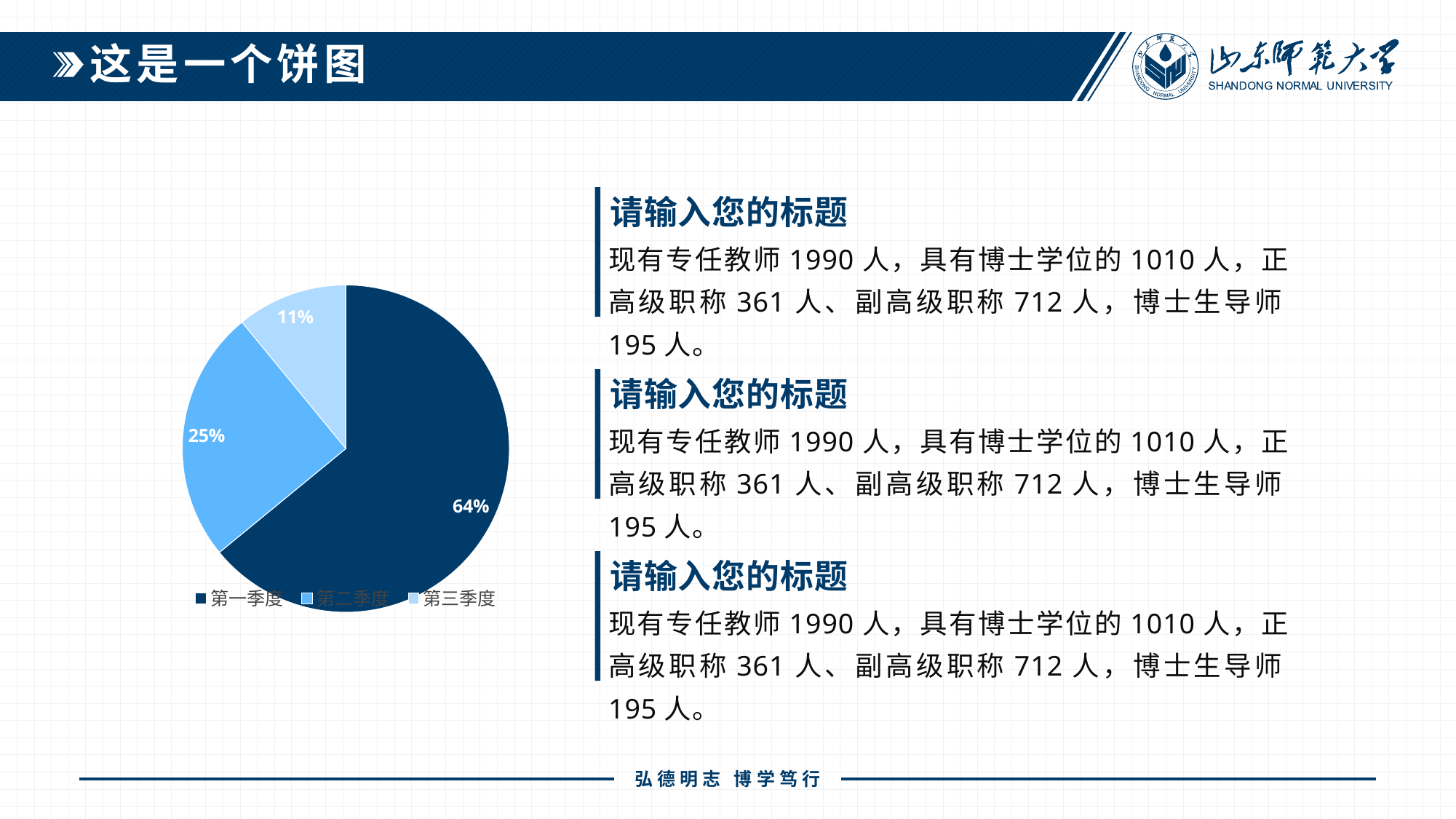
What share of the pie does 第一季度 represent? 64% What share of the pie does 第二季度 represent? 25% Which slice is larger, 第二季度 or 第三季度? 第二季度 What is the difference in percentage points between the 第二季度 and 第三季度 slices? 14 Which legend entry is shown with the darkest blue colour? 第一季度 What is the difference in percentage points between the 第一季度 and 第二季度 slices? 39 What share of the pie does 第三季度 represent? 11% Which category has the largest slice of the pie? 第一季度 How many slices does the pie chart have? 3 How many entries does the legend list? 3 Which category has the smallest slice of the pie? 第三季度 What kind of chart is shown on the slide? pie chart